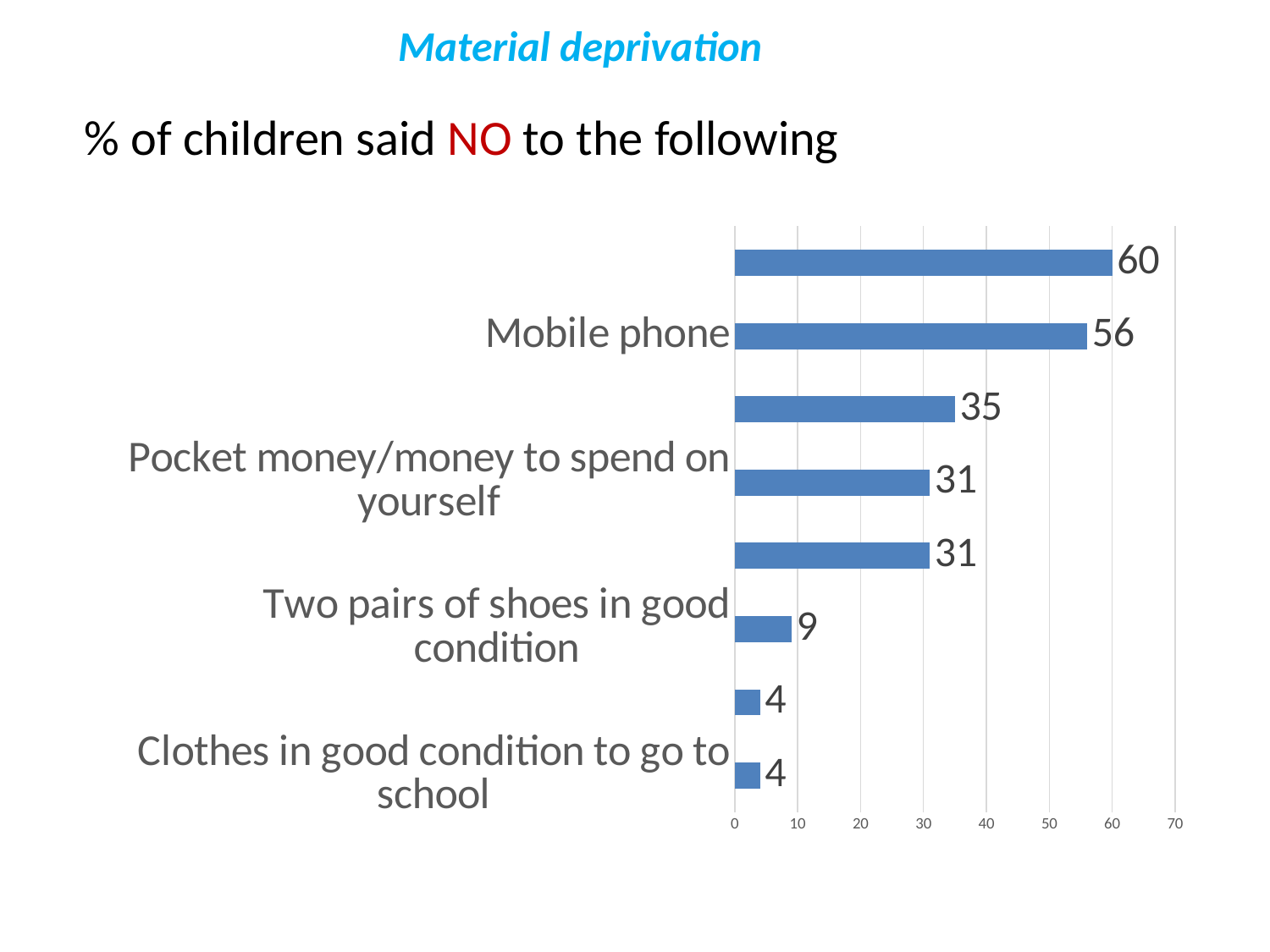
How many bars are plotted on the chart? 8 What is the value for Pocket money/money to spend on yourself? 31 What is the heading text above the chart? % of children said NO to the following What is the value for Clothes in good condition to go to school? 4 What kind of chart is shown on the slide? Bar chart Which is larger, the value for Mobile phone or the value for Pocket money/money to spend on yourself? Mobile phone What is the difference between the values for Mobile phone and Two pairs of shoes in good condition? 47 What is the value for Two pairs of shoes in good condition? 9 What is the value for Mobile phone? 56 What is the highest value shown on the chart? 60 Is the value for Mobile phone greater or less than 50? greater What is the lowest value shown on the chart? 4